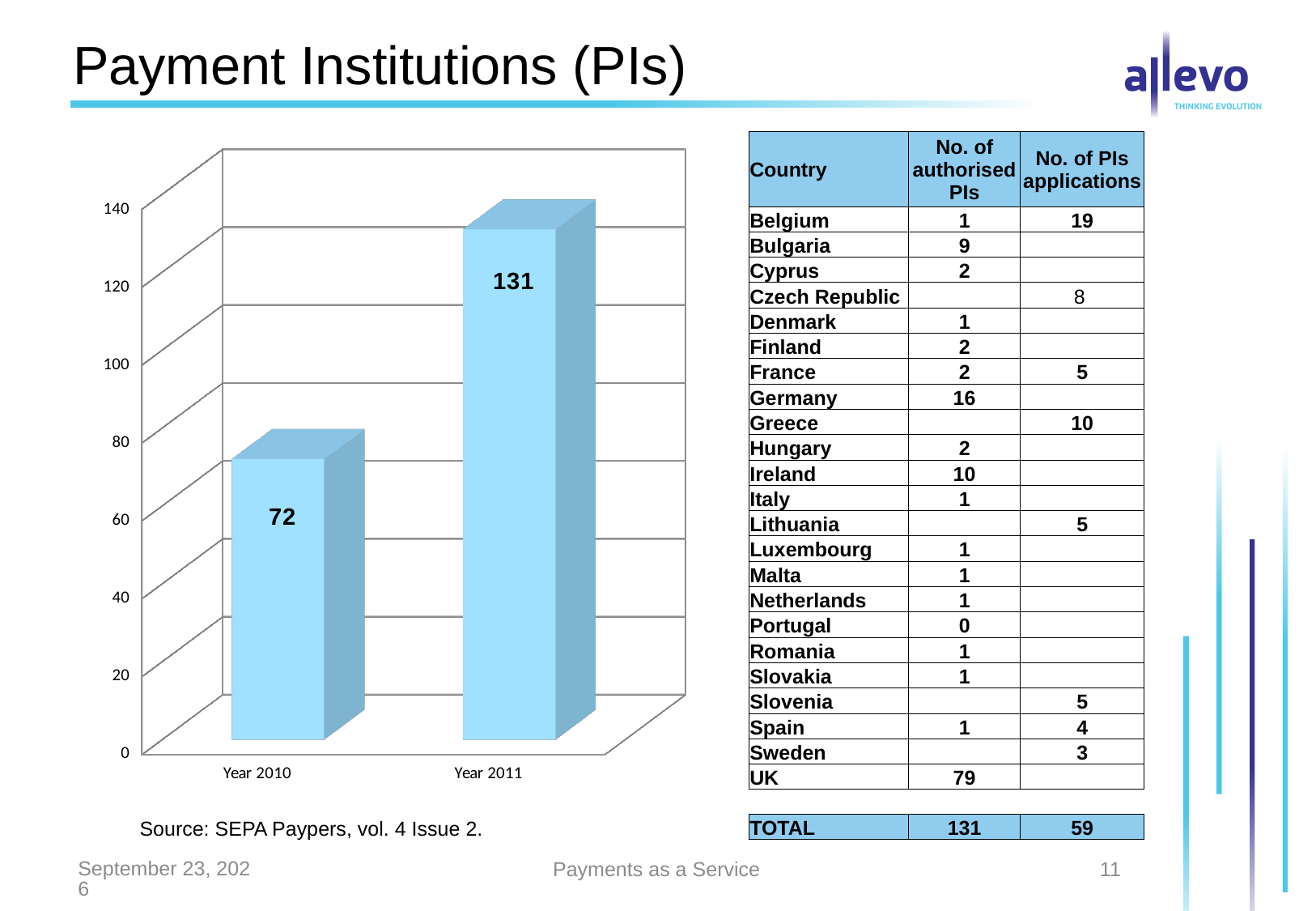
Which is larger in the bar chart, the value for Year 2010 or Year 2011? Year 2011 What is the highest tick value shown on the vertical axis of the bar chart? 140 What is the value for Year 2011 in the bar chart? 131 What is the value for Year 2010 in the bar chart? 72 Do the values rise or fall from Year 2010 to Year 2011 in the bar chart? rise Which year has the highest value in the bar chart? Year 2011 Is the value for Year 2011 greater or less than 120? greater How many categories are shown on the x axis of the bar chart? 2 Which year has the lowest value in the bar chart? Year 2010 What is the difference between the values for Year 2011 and Year 2010 in the bar chart? 59 Is the value for Year 2010 greater or less than 80? less What kind of chart is shown on the slide? bar chart